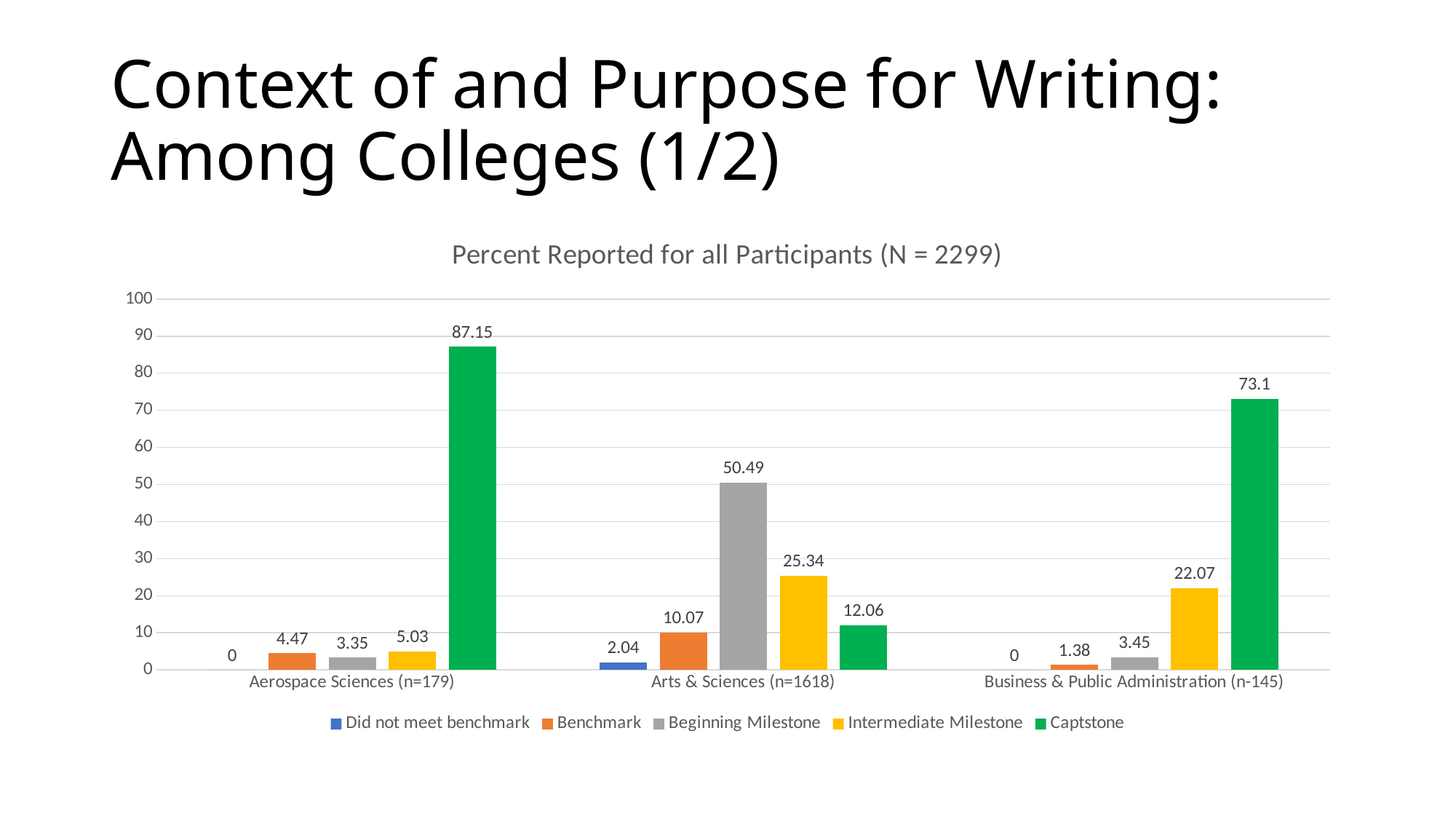
What is the title of the chart? Percent Reported for all Participants (N = 2299) What is the difference between the Captstone values for Aerospace Sciences (n=179) and Business & Public Administration (n-145)? 14.05 What is the Did not meet benchmark value for Arts & Sciences (n=1618)? 2.04 Which college has the highest Captstone value? Aerospace Sciences (n=179) Which college has the lowest Benchmark value? Business & Public Administration (n-145) What is the Beginning Milestone value for Arts & Sciences (n=1618)? 50.49 What is the Intermediate Milestone value for Business & Public Administration (n-145)? 22.07 What is the Captstone value for Aerospace Sciences (n=179)? 87.15 What kind of chart is shown on the slide? Bar chart Which is larger for Arts & Sciences (n=1618): the Intermediate Milestone value or the Captstone value? Intermediate Milestone How many series does the legend list? 5 How many colleges are shown on the x axis? 3